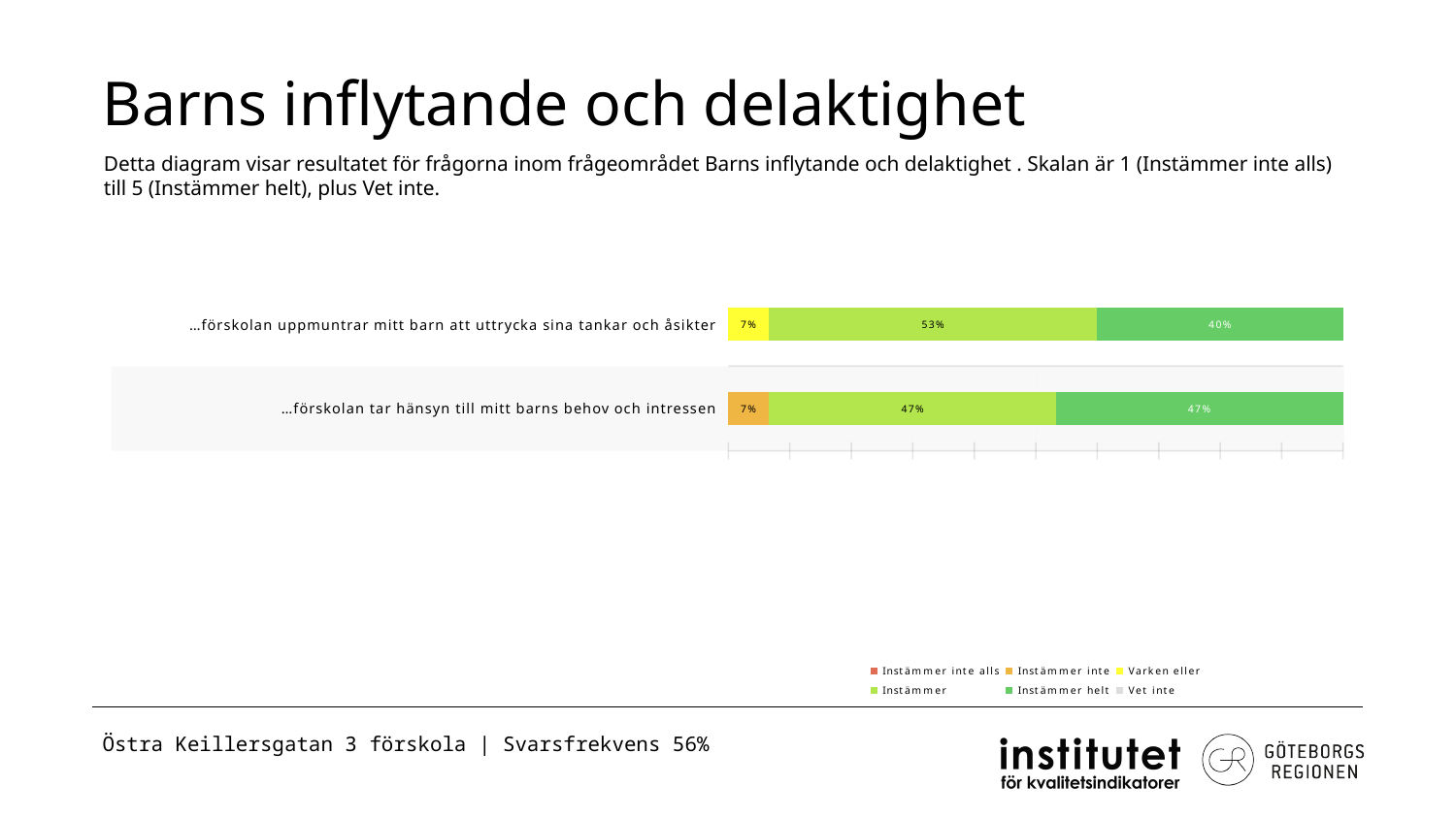
Which statement has the larger 'Instämmer helt' share? …förskolan tar hänsyn till mitt barns behov och intressen What is the 'Instämmer helt' value for '…förskolan uppmuntrar mitt barn att uttrycka sina tankar och åsikter'? 40% What is the 'Instämmer' value for '…förskolan tar hänsyn till mitt barns behov och intressen'? 47% What is the 'Instämmer' value for '…förskolan uppmuntrar mitt barn att uttrycka sina tankar och åsikter'? 53% What is the difference in the 'Instämmer helt' value between the two statements? 7 percentage points What is the total of the labelled segments in the bar for '…förskolan uppmuntrar mitt barn att uttrycka sina tankar och åsikter'? 100% What is the difference in the 'Instämmer' value between the two statements? 6 percentage points What is the title of the slide containing the chart? Barns inflytande och delaktighet How many statements (categories) are plotted in the chart? 2 Which statement has the highest 'Instämmer' value? …förskolan uppmuntrar mitt barn att uttrycka sina tankar och åsikter What kind of chart is shown on the slide? Stacked bar chart How many series does the legend list? 6